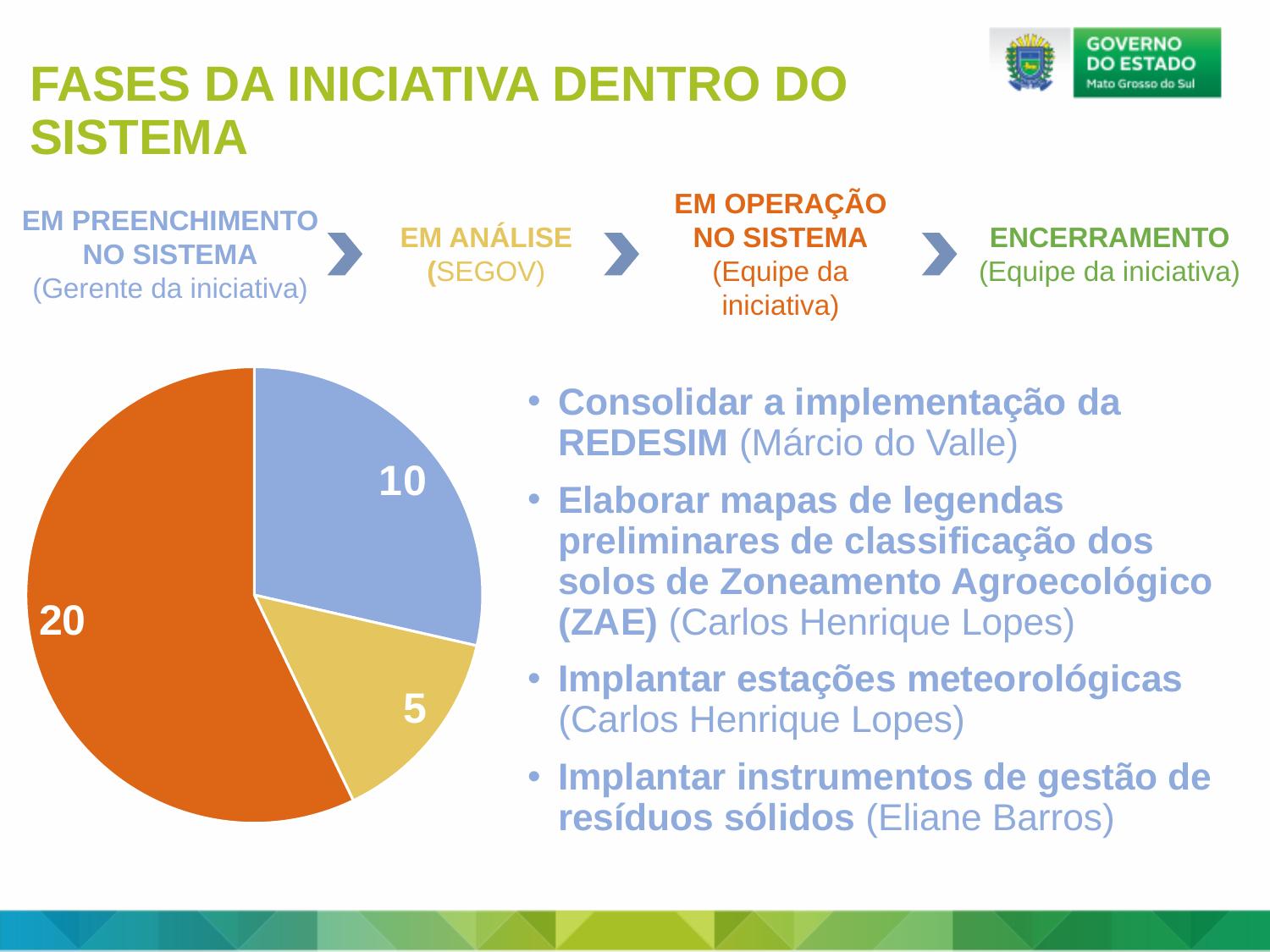
What value is labelled on the orange slice of the pie chart? 20 Does the pie chart include a legend? No Which slice of the pie chart has the smallest value? the yellow slice (5) What is the difference between the orange slice and the blue slice in the pie chart? 10 What kind of chart is shown on the left of the slide? pie chart What is the difference between the blue slice and the yellow slice in the pie chart? 5 Which is larger in the pie chart, the blue slice or the yellow slice? the blue slice How many slices does the pie chart have? 3 Which slice of the pie chart has the largest value? the orange slice (20) What value is labelled on the yellow slice of the pie chart? 5 What is the sum of all the values shown in the pie chart? 35 What value is labelled on the blue slice of the pie chart? 10